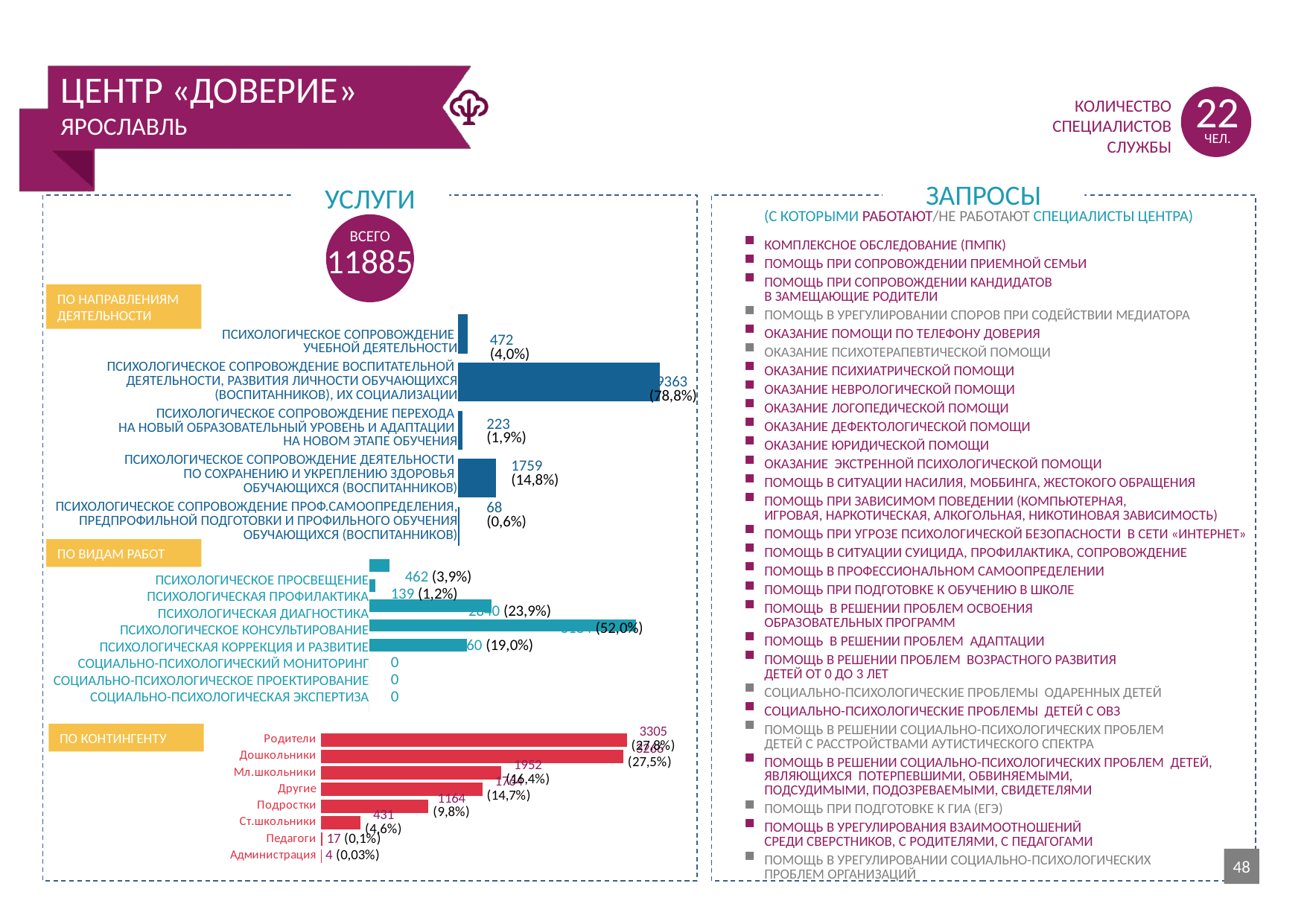
In the 'По видам работ' chart, how many categories are listed? 8 In the 'По направлениям деятельности' chart, what is the difference between the value for 'Психологическое сопровождение деятельности по сохранению и укреплению здоровья' (1759) and 'Психологическое сопровождение учебной деятельности' (472)? 1287 In the 'По направлениям деятельности' chart, which category has the lowest value? Психологическое сопровождение проф.самоопределения, предпрофильной подготовки и профильного обучения обучающихся (воспитанников) In the 'По направлениям деятельности' chart, what is the value for 'Психологическое сопровождение учебной деятельности'? 472 In the 'По контингенту' chart, which is larger: 'Подростки' or 'Ст.школьники'? Подростки In the 'По контингенту' chart, what is the value for 'Подростки'? 1164 (9,8%) In the 'По видам работ' chart, what is the value for 'Психологическая профилактика'? 139 (1,2%) In the 'По направлениям деятельности' chart, which category has the highest value? Психологическое сопровождение воспитательной деятельности, развития личности обучающихся (воспитанников), их социализации What kind of chart is used in the 'По контингенту' section? Bar chart In the 'По видам работ' chart, what is the difference between 'Психологическое просвещение' (462) and 'Психологическая профилактика' (139)? 323 In the 'По контингенту' chart, which category has the lowest value? Администрация In the 'По направлениям деятельности' chart, what percentage is shown for 'Психологическое сопровождение деятельности по сохранению и укреплению здоровья обучающихся (воспитанников)'? 14,8%